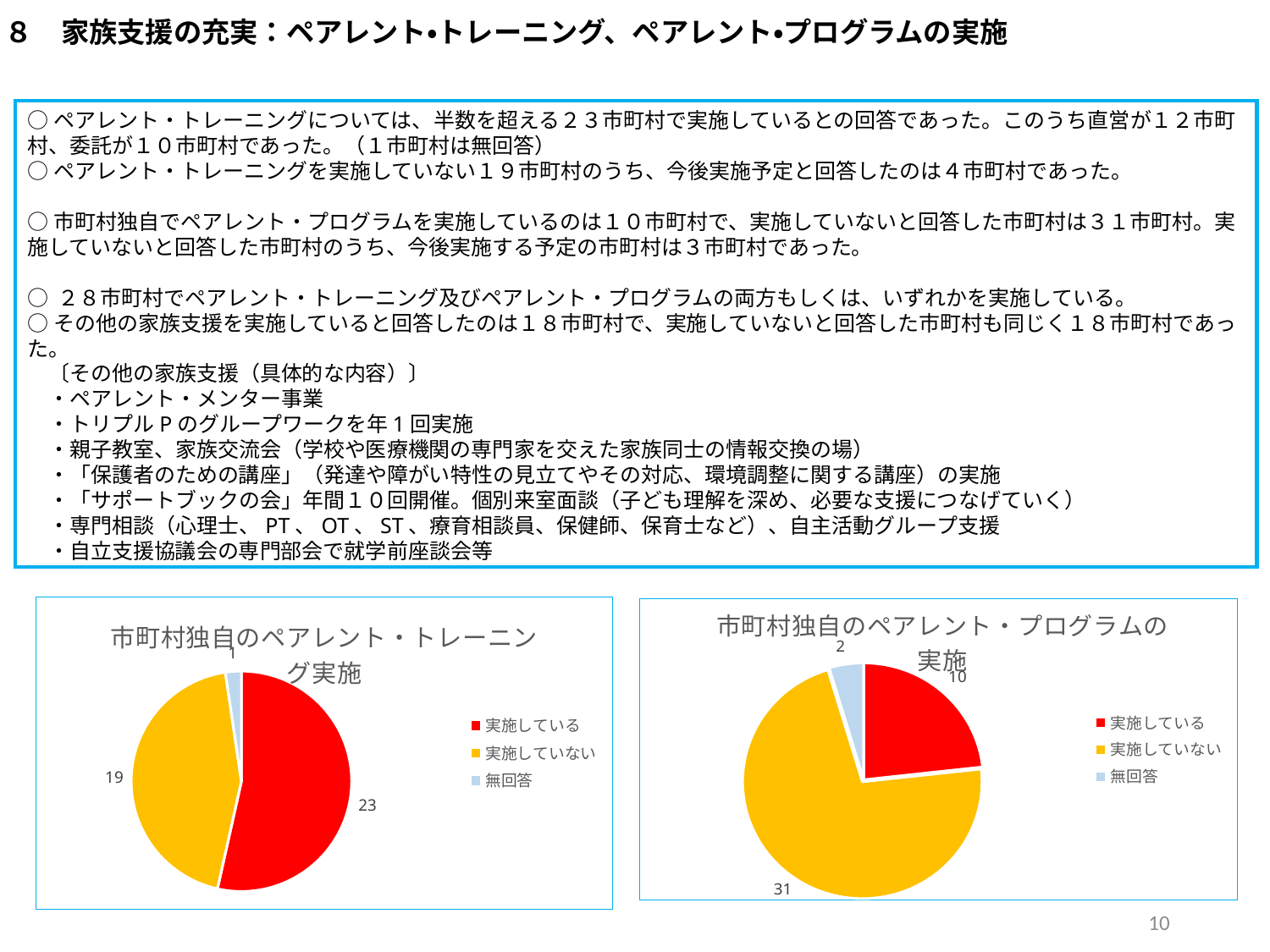
In the left chart (市町村独自のペアレント・トレーニング実施), which category has the smallest slice? 無回答 In the right chart (市町村独自のペアレント・プログラムの実施), what is the difference between 実施していない and 実施している? 21 In the left chart (市町村独自のペアレント・トレーニング実施), what is the value for 実施している? 23 In the left chart (市町村独自のペアレント・トレーニング実施), what is the difference between 実施している and 実施していない? 4 What type of chart is the right chart (市町村独自のペアレント・プログラムの実施)? Pie chart In the right chart (市町村独自のペアレント・プログラムの実施), what is the value for 実施していない? 31 How many categories does the legend of the left chart (市町村独自のペアレント・トレーニング実施) list? 3 In the left chart (市町村独自のペアレント・トレーニング実施), what is the value for 無回答? 1 In the left chart (市町村独自のペアレント・トレーニング実施), which is larger, 実施している or 実施していない? 実施している In the left chart (市町村独自のペアレント・トレーニング実施), what is the value for 実施していない? 19 In the right chart (市町村独自のペアレント・プログラムの実施), which category has the largest slice? 実施していない In the right chart (市町村独自のペアレント・プログラムの実施), what is the value for 実施している? 10